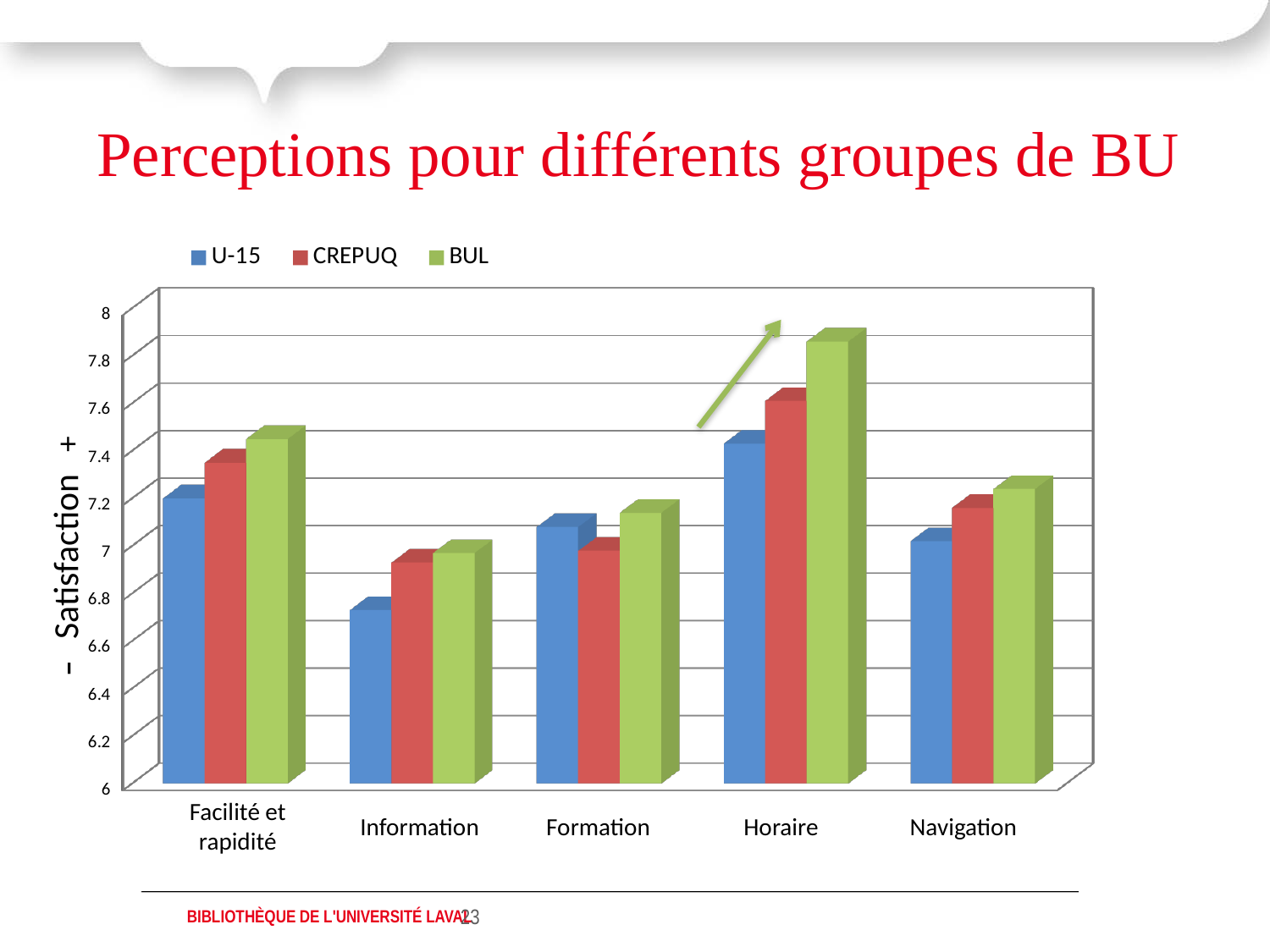
Is the U-15 value for Information greater or less than 7? less Is the BUL value for Horaire greater or less than 7.6? greater For which category is the CREPUQ value highest? Horaire For Horaire, which is larger: the U-15 value or the BUL value? BUL How many series does the legend list? 3 For which category is the BUL value highest? Horaire How many categories are shown on the x axis? 5 Which series are listed in the legend? U-15, CREPUQ, BUL What is the label on the vertical axis? - Satisfaction + For which category is the U-15 value lowest? Information For Facilité et rapidité, which is larger: the U-15 value or the CREPUQ value? CREPUQ What kind of chart is shown on the slide? Bar chart